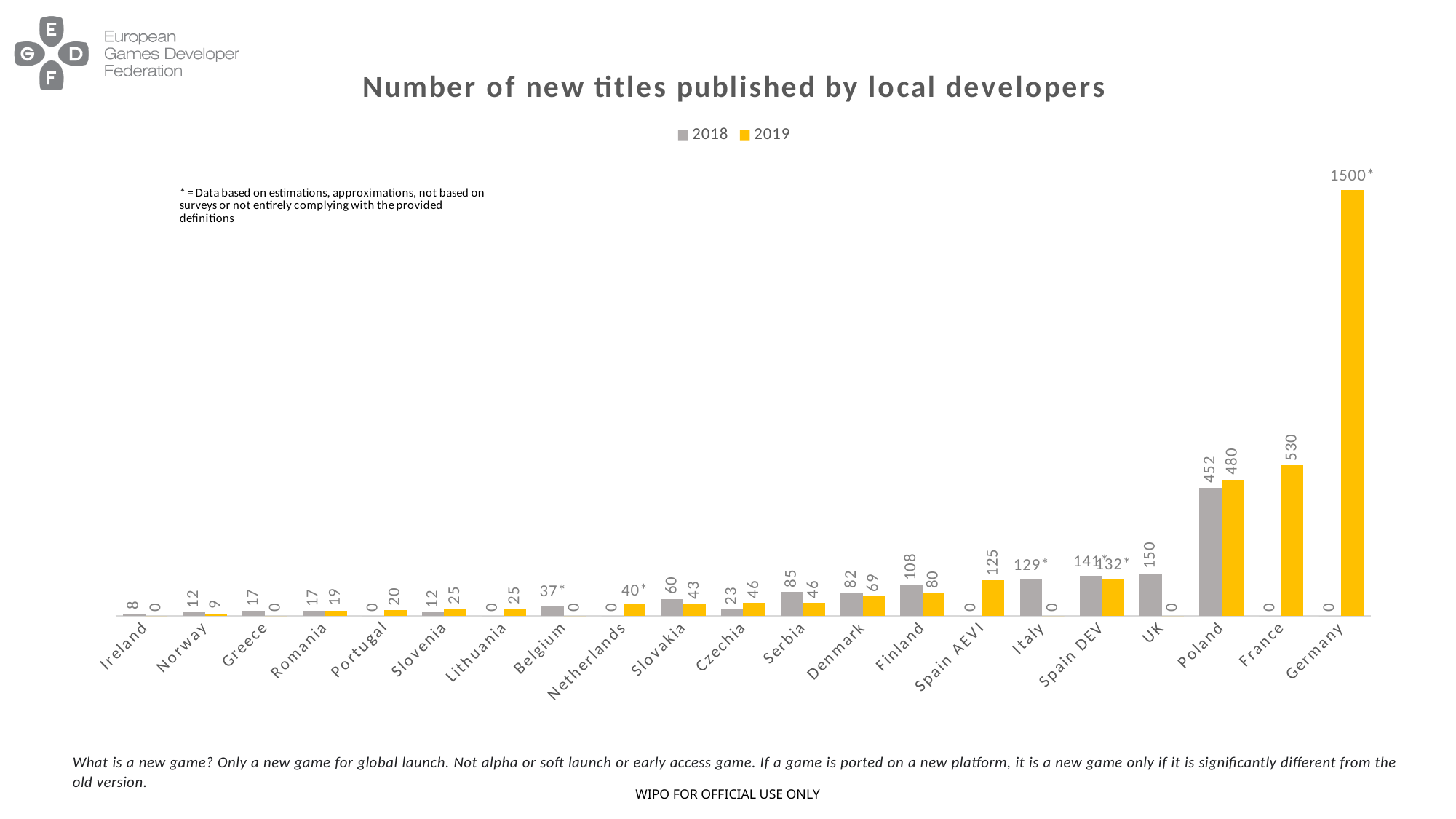
Which country has the highest 2019 value? Germany What is the 2018 value for the UK? 150 Which country has the highest 2018 value? Poland How many series does the legend list? 2 For Finland, which year has the larger value, 2018 or 2019? 2018 What is the 2019 value for Poland? 480 What is the 2019 value for France? 530 What kind of chart is shown on the slide? bar chart How many countries/categories are shown on the x axis? 21 What is the difference between Poland's 2019 and 2018 values? 28 What is the 2018 value for Finland? 108 What colour represents the 2019 series in the legend? yellow